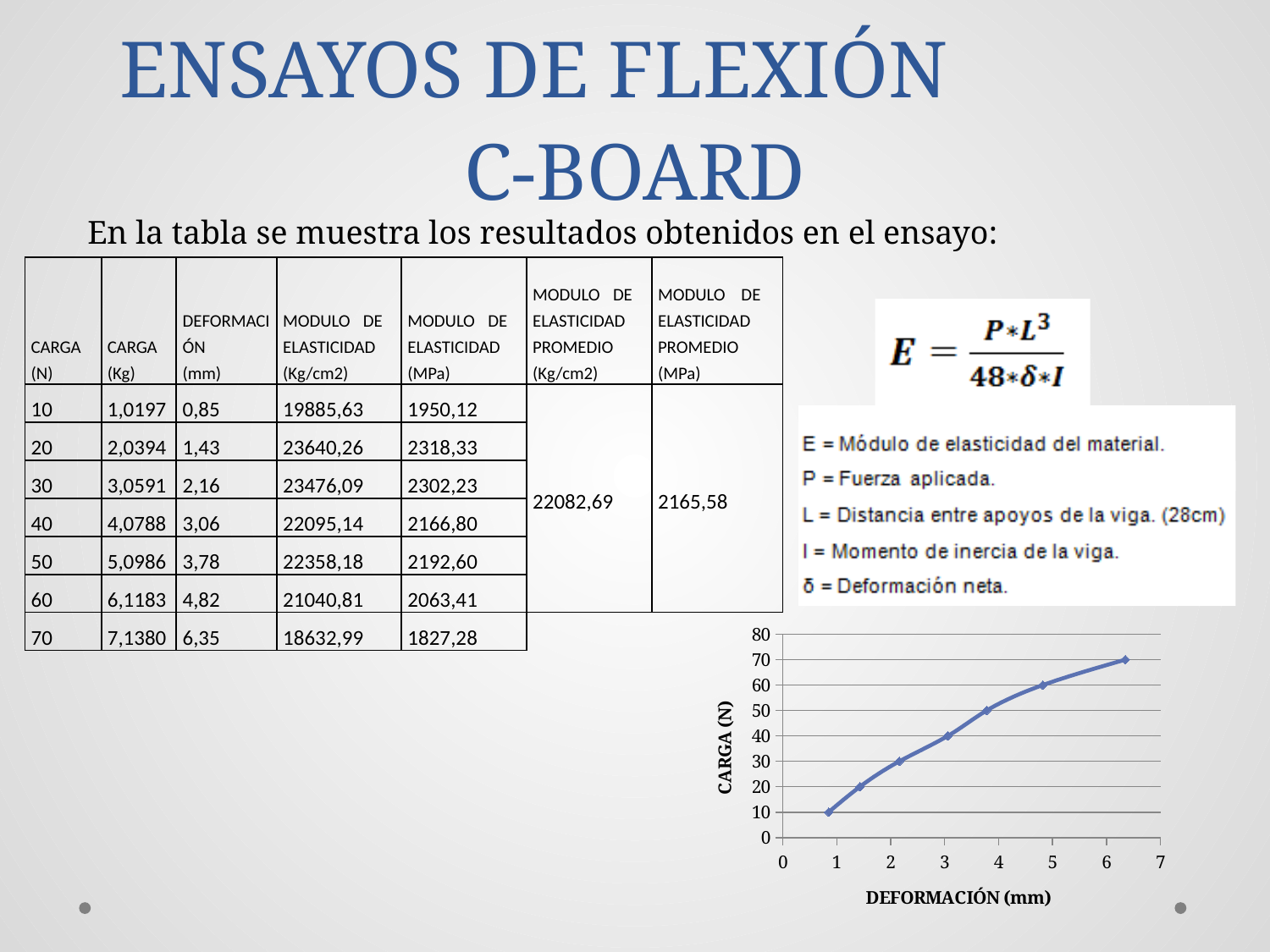
How many data points are plotted on the CARGA (N) vs DEFORMACIÓN (mm) chart? 7 What is the lowest CARGA (N) value plotted on the chart? 10 What is the difference between the highest and lowest CARGA (N) values plotted on the chart? 60 What kind of chart is shown at the bottom right of the slide? line chart What is the highest CARGA (N) value plotted on the chart? 70 What is the title of the y axis of the chart? CARGA (N) What is the title of the x axis of the chart? DEFORMACIÓN (mm) On the chart, which is larger: the load at the last plotted point or the load at the first plotted point? the last plotted point On the chart, is the deformation at a load of 70 N greater or less than 6 mm? greater On the chart, does the load (CARGA) rise or fall as deformation increases along the x axis? rises